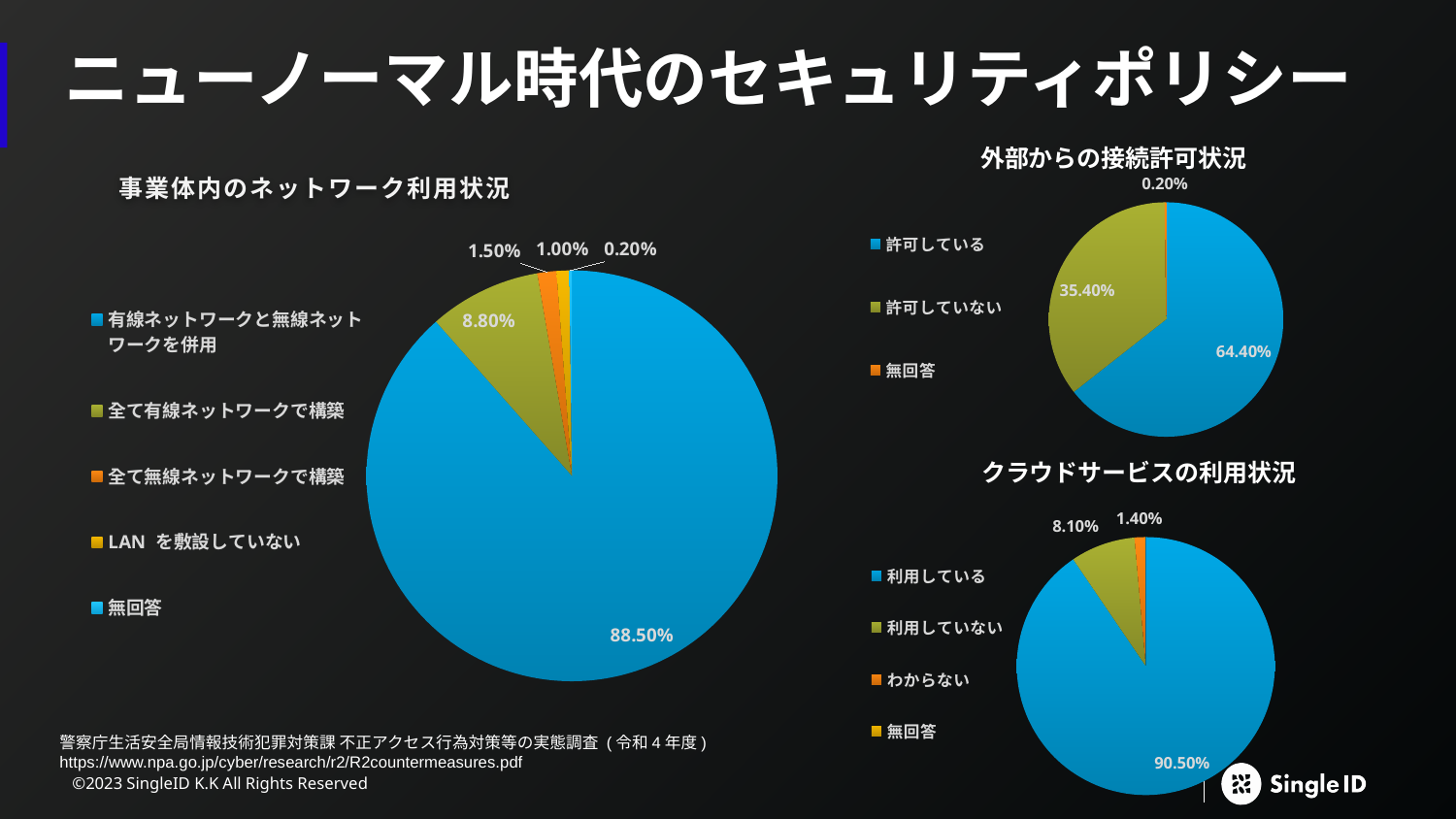
In the 事業体内のネットワーク利用状況 chart, what is the difference between 全て無線ネットワークで構築 and LAN を敷設していない? 0.50% In the 事業体内のネットワーク利用状況 chart, what share is 全て有線ネットワークで構築? 8.80% In the クラウドサービスの利用状況 chart, which is larger, 利用していない or わからない? 利用していない What kind of chart is the クラウドサービスの利用状況 chart? Pie chart In the 事業体内のネットワーク利用状況 chart, what share is 有線ネットワークと無線ネットワークを併用? 88.50% How many charts are shown on the slide? 3 In the 外部からの接続許可状況 chart, what share is 許可している? 64.40% In the クラウドサービスの利用状況 chart, what share is 利用している? 90.50% In the 外部からの接続許可状況 chart, what is the difference between 許可している and 許可していない? 29.00% In the 外部からの接続許可状況 chart, what share is 許可していない? 35.40% In the 事業体内のネットワーク利用状況 chart, which category has the smallest share? 無回答 How many categories does the legend of the 事業体内のネットワーク利用状況 chart list? 5